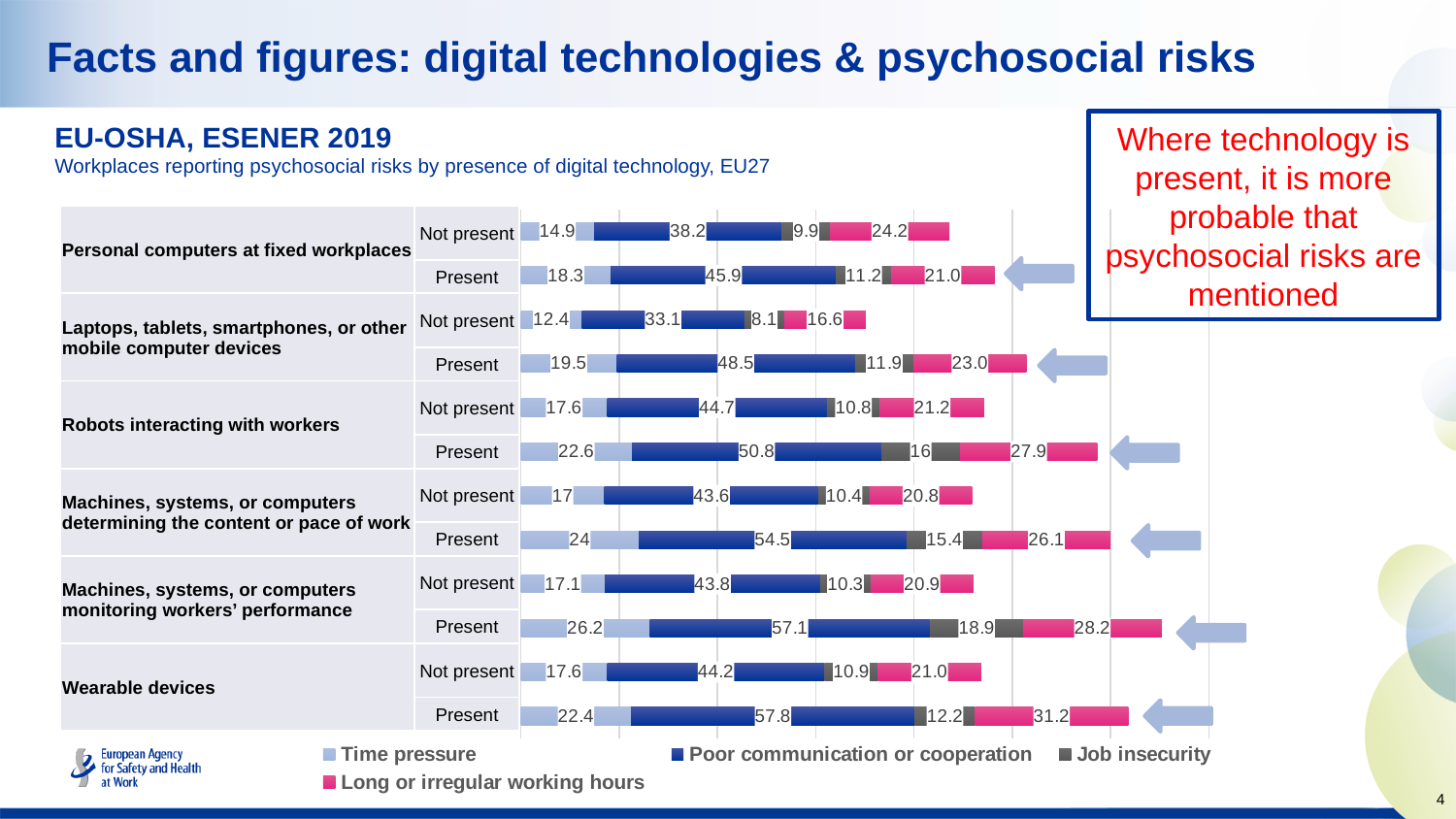
What is the Job insecurity value for 'Present' under Robots interacting with workers? 16 Which bar has the highest Poor communication or cooperation value? Wearable devices, Present What is the Time pressure value for 'Present' under Machines, systems, or computers monitoring workers' performance? 26.2 What kind of chart is shown on the slide? Stacked bar chart What is the total of the stacked bar for 'Present' under Wearable devices? 123.6 How many series does the legend list? 4 What is the difference in Time pressure between 'Present' and 'Not present' for Machines, systems, or computers determining the content or pace of work? 7 How many stacked bars are plotted in the chart? 12 What is the Long or irregular working hours value for 'Present' under Wearable devices? 31.2 For Personal computers at fixed workplaces, is the Long or irregular working hours value larger for 'Not present' or 'Present'? Not present Which bar has the lowest Time pressure value? Laptops, tablets, smartphones, or other mobile computer devices, Not present What is the Poor communication or cooperation value for 'Not present' under Laptops, tablets, smartphones, or other mobile computer devices? 33.1